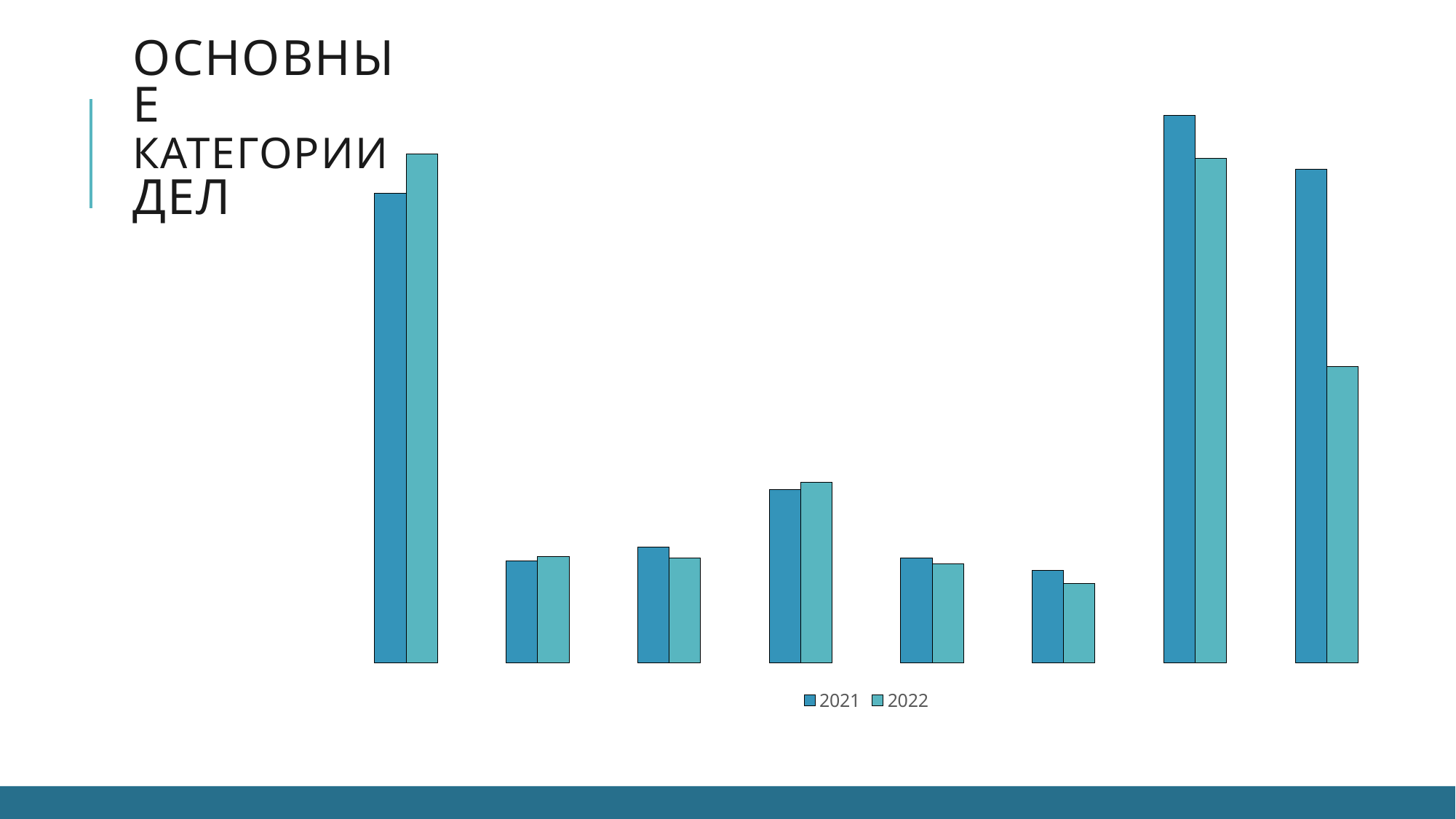
What kind of chart is shown on the slide? bar chart Which group of bars, counted from the left, has the tallest 2021 bar? the seventh In the leftmost group of bars, which series has the larger value, 2021 or 2022? 2022 What are the series names listed in the legend? 2021 and 2022 In the rightmost group of bars, which series has the larger value, 2021 or 2022? 2021 How many series does the legend list? 2 Which group of bars, counted from the left, has the shortest 2022 bar? the sixth How many groups of bars (categories) are plotted in the chart? 8 What is the title text on the slide above the chart? ОСНОВНЫЕ КАТЕГОРИИ ДЕЛ In the second group from the right, which series has the larger value, 2021 or 2022? 2021